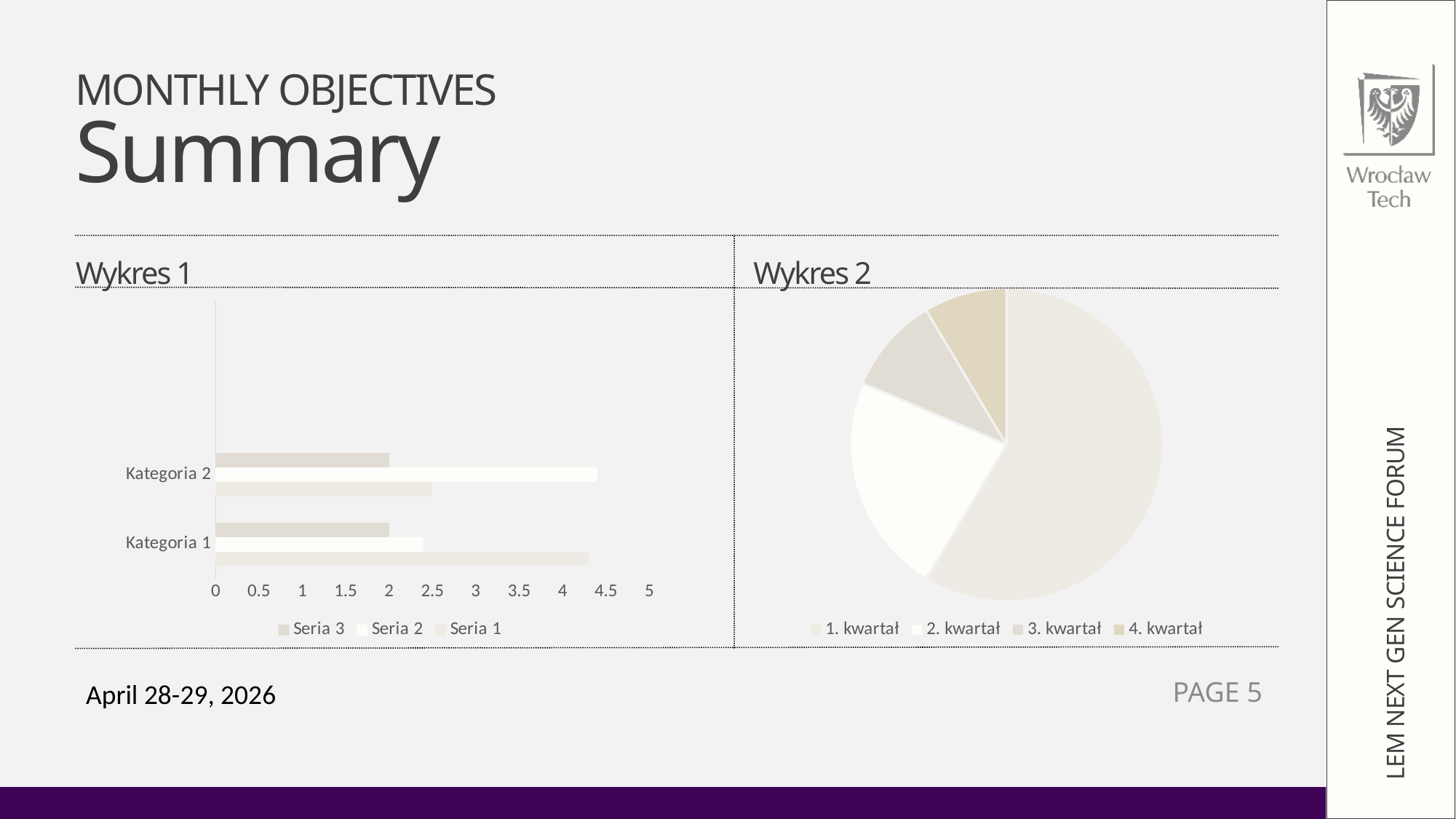
In Wykres 2, which slice is larger: 2. kwartał or 4. kwartał? 2. kwartał In Wykres 1, is the value of Seria 1 for Kategoria 2 greater or less than 3? less What kind of chart is Wykres 1? bar chart In Wykres 2, which slice is the largest? 1. kwartał In Wykres 1, how many series does the legend list? 3 In Wykres 1, for Kategoria 2, which is larger: Seria 2 or Seria 1? Seria 2 In Wykres 2, how many slices does the pie have? 4 In Wykres 1, which series has the highest value for Kategoria 1? Seria 1 In Wykres 1, what is the value of Seria 3 for Kategoria 1? 2 What kind of chart is Wykres 2? pie chart In Wykres 1, how many categories are shown on the vertical axis? 2 In Wykres 1, is the value of Seria 2 for Kategoria 2 greater or less than 4? greater